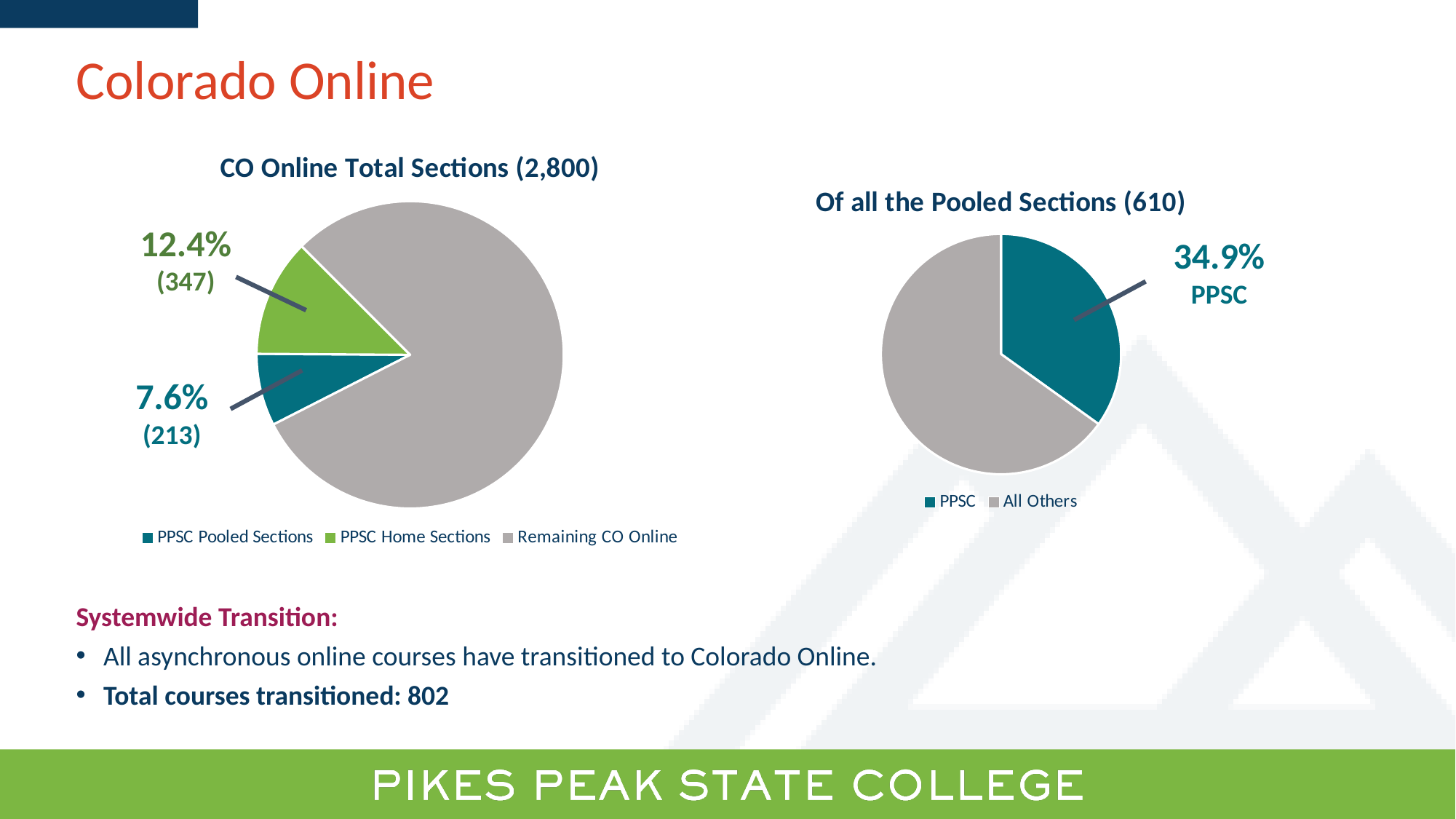
In the 'CO Online Total Sections (2,800)' chart, how many more sections are PPSC Home Sections than PPSC Pooled Sections? 134 In the 'CO Online Total Sections (2,800)' chart, which slice is the smallest? PPSC Pooled Sections In the 'CO Online Total Sections (2,800)' chart, how many slices does the pie have? 3 In the 'CO Online Total Sections (2,800)' chart, how many sections are PPSC Pooled Sections? 213 In the 'CO Online Total Sections (2,800)' chart, what percentage share do PPSC Home Sections have? 12.4% In the 'CO Online Total Sections (2,800)' chart, how many sections are PPSC Home Sections? 347 In the 'Of all the Pooled Sections (610)' chart, how many entries does the legend list? 2 In the 'Of all the Pooled Sections (610)' chart, which slice is larger, PPSC or All Others? All Others In the 'CO Online Total Sections (2,800)' chart, which slice is the largest? Remaining CO Online What type of chart is the chart on the right side of the slide? Pie chart In the 'Of all the Pooled Sections (610)' chart, what percentage share does PPSC have? 34.9% In the 'CO Online Total Sections (2,800)' chart, what percentage share do PPSC Pooled Sections have? 7.6%